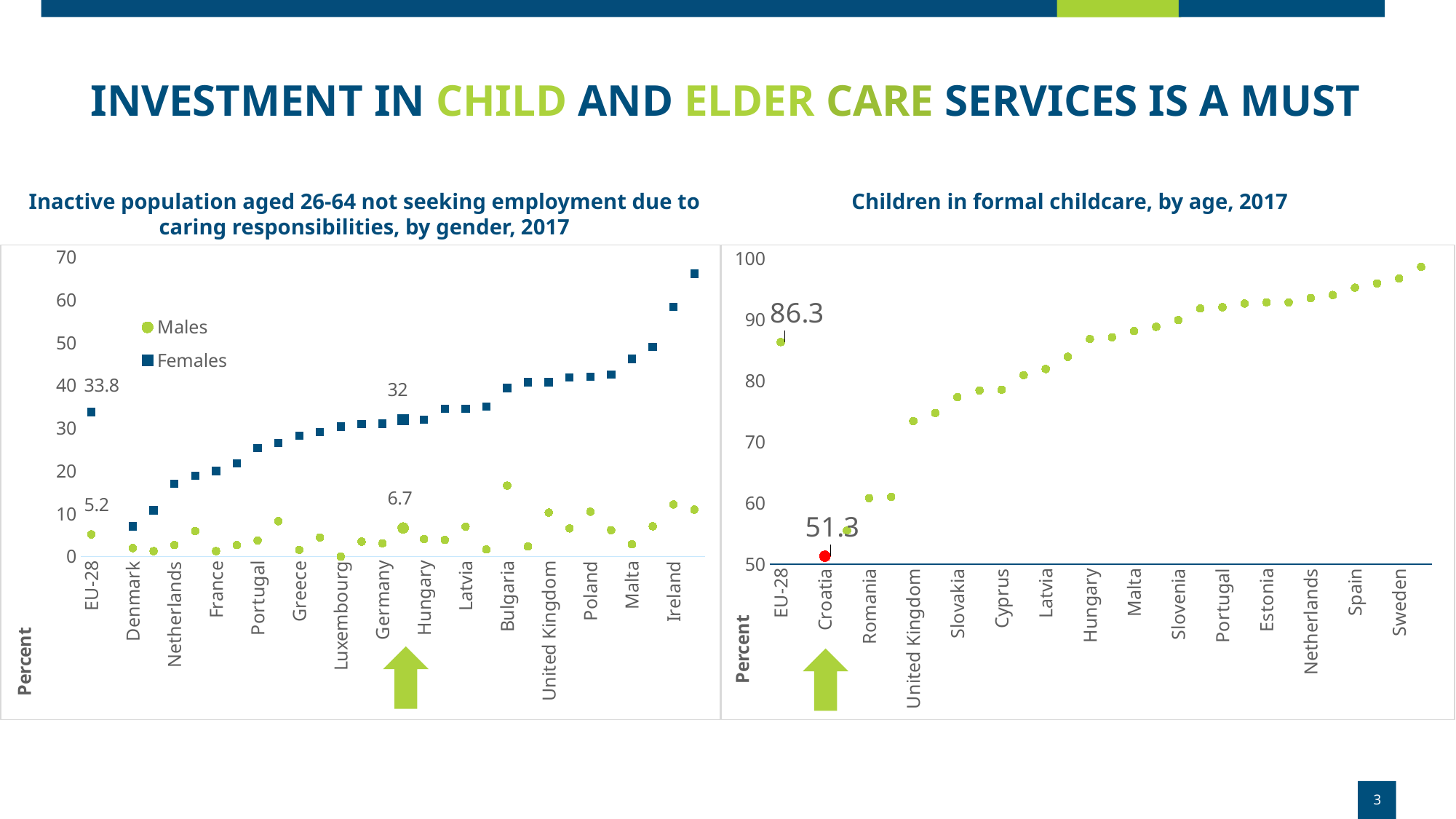
On the left chart (Inactive population aged 26-64 not seeking employment due to caring responsibilities), what is the value for Females for EU-28? 33.8 On the right chart (Children in formal childcare, by age, 2017), what is the value for Croatia? 51.3 On the left chart (Inactive population aged 26-64 not seeking employment due to caring responsibilities), which series has the larger value for EU-28, Males or Females? Females On the right chart (Children in formal childcare, by age, 2017), what is the value for EU-28? 86.3 On the right chart (Children in formal childcare, by age, 2017), what is the difference between the EU-28 value and the Croatia value? 35.0 On the left chart (Inactive population aged 26-64 not seeking employment due to caring responsibilities), how many series does the legend list? 2 On the right chart (Children in formal childcare, by age, 2017), is the value for Romania greater or less than 70? less On the left chart (Inactive population aged 26-64 not seeking employment due to caring responsibilities), what is the difference between the Females and Males values for EU-28? 28.6 On the left chart (Inactive population aged 26-64 not seeking employment due to caring responsibilities), what is the value for Males for EU-28? 5.2 On the left chart (Inactive population aged 26-64 not seeking employment due to caring responsibilities), do the Females values rise or fall from left to right along the x axis? rise